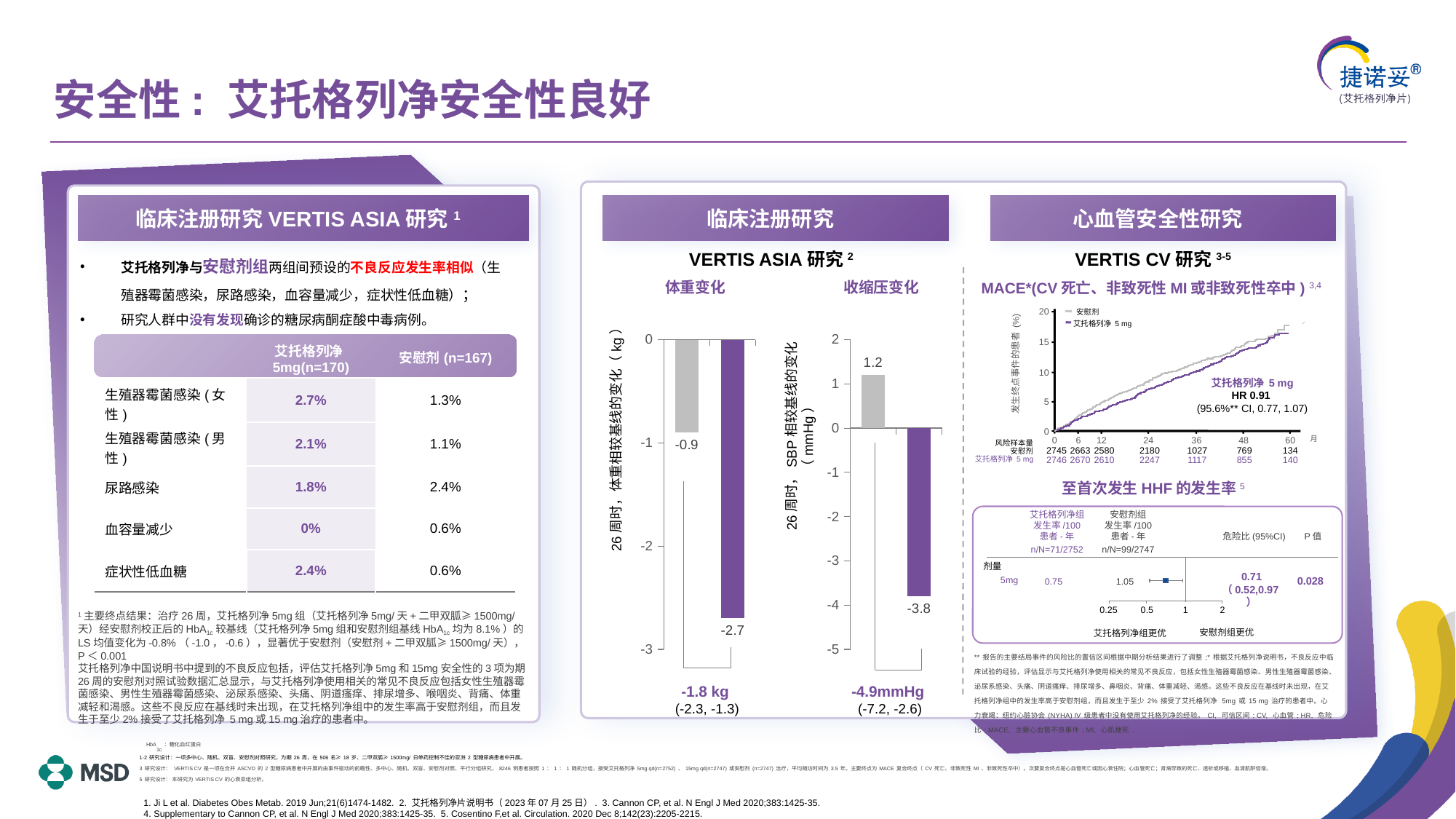
In the 收缩压变化 chart, what is the value of the purple bar? -3.8 What kind of chart is the 体重变化 chart? bar chart In the 收缩压变化 chart, which bar has the lower value, the gray bar or the purple bar? the purple bar In the MACE chart, do the curves rise or fall as the months increase? rise How many series does the legend of the MACE chart list? 2 In the 收缩压变化 chart, what is the value of the gray bar? 1.2 In the MACE chart, what hazard ratio (HR) is printed for 艾托格列净 5 mg? HR 0.91 In the 体重变化 chart, what is the value of the purple bar? -2.7 In the 至首次发生 HHF 的发生率 forest plot, what is the 危险比 (95%CI) for the 5mg dose? 0.71 (0.52,0.97) In the 体重变化 chart, what is the difference between the two bars shown below the chart? -1.8 kg In the 体重变化 chart, what is the value of the gray bar? -0.9 What kind of chart is the MACE chart? line chart